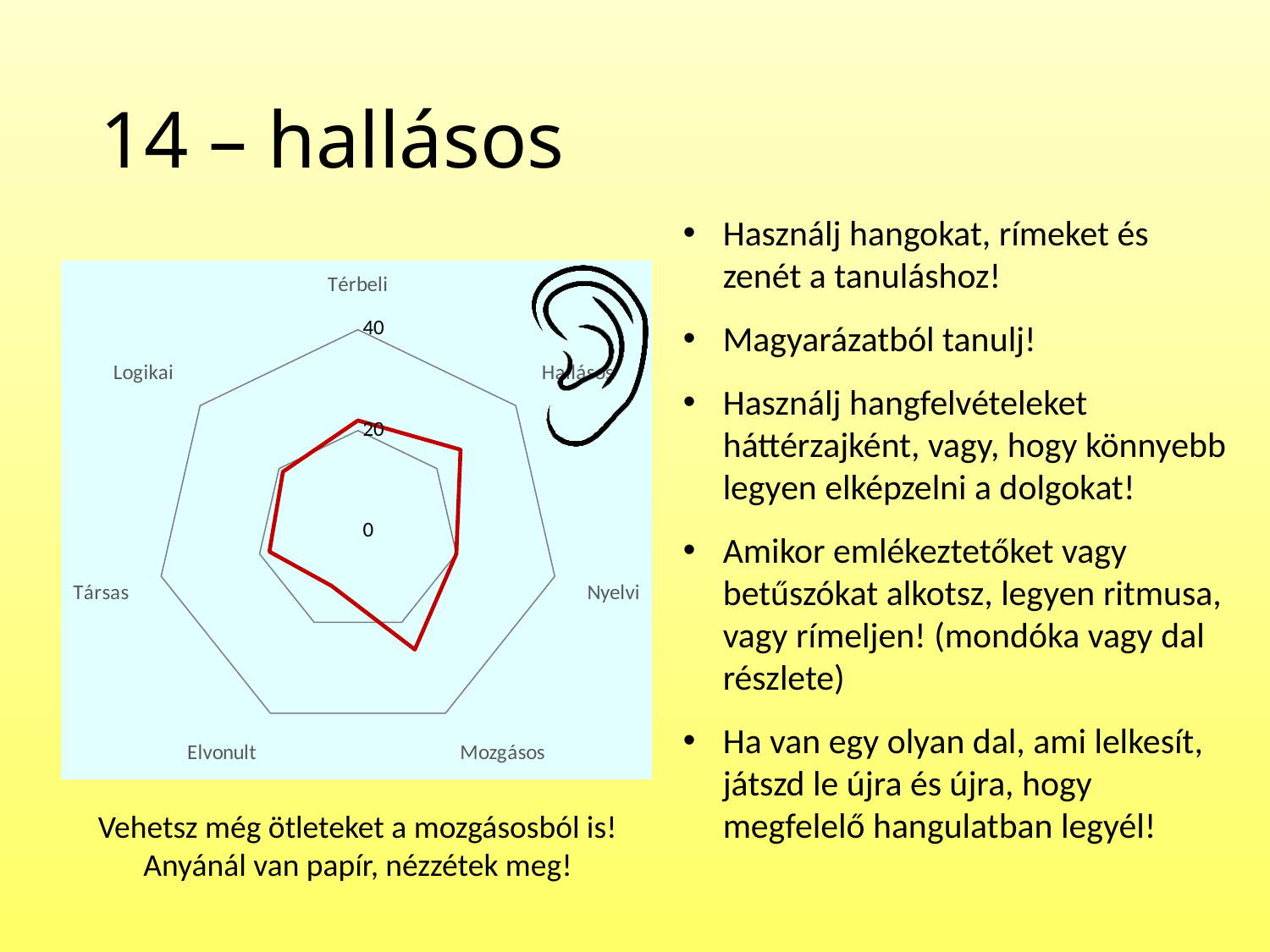
What colour is the data line on the radar chart? red Is the value for Elvonult greater or less than 20? less Which is larger, the value for Mozgásos or the value for Elvonult? Mozgásos How many categories does the radar chart have? 7 Is the value for Mozgásos greater or less than 20? greater What is the highest value shown on the radar chart's axis? 40 Which category has the lowest value on the radar chart? Elvonult Which is larger, the value for Hallásos or the value for Elvonult? Hallásos Is the value for Hallásos greater or less than 20? greater What kind of chart is shown on the slide? radar chart